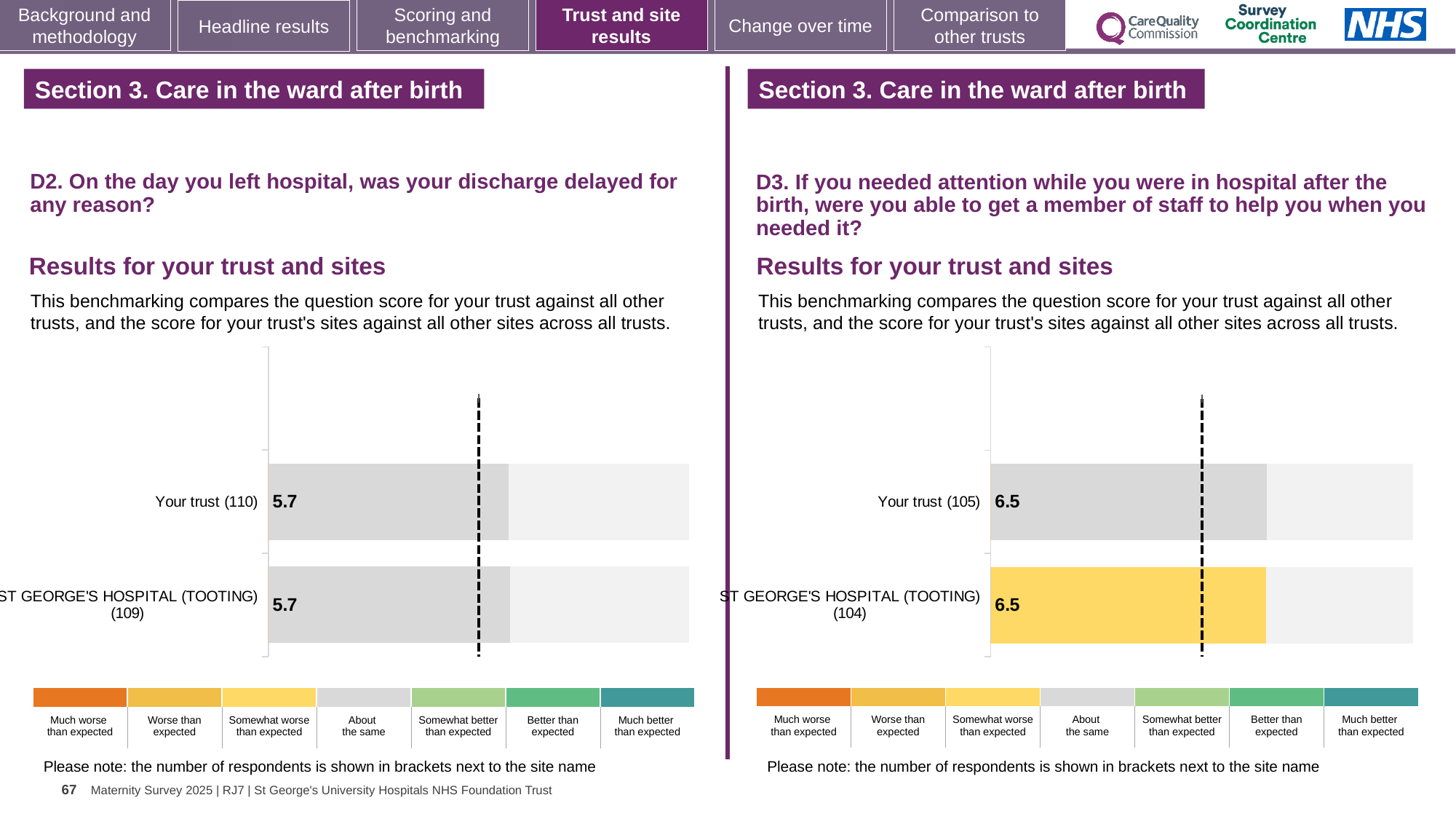
On the right chart (D3), what is the score for Your trust? 6.5 On the left chart (D2), what is the difference between the score for Your trust and the score for St George's Hospital (Tooting)? 0 On the right chart (D3), what is the score for St George's Hospital (Tooting)? 6.5 On the right chart (D3), how many respondents are shown in brackets for St George's Hospital (Tooting)? 104 How many bars are plotted on the left chart (D2)? 2 On the right chart (D3), which benchmark category does the colour of the St George's Hospital (Tooting) bar correspond to in the legend? Somewhat worse than expected On the left chart (D2), what is the score for Your trust? 5.7 How many bars are plotted on the right chart (D3)? 2 On the left chart (D2), what is the score for St George's Hospital (Tooting)? 5.7 On the right chart (D3), what is the difference between the score for Your trust and the score for St George's Hospital (Tooting)? 0 What kind of chart is used on the left (D2)? Bar chart On the left chart (D2), how many respondents are shown in brackets for Your trust? 110